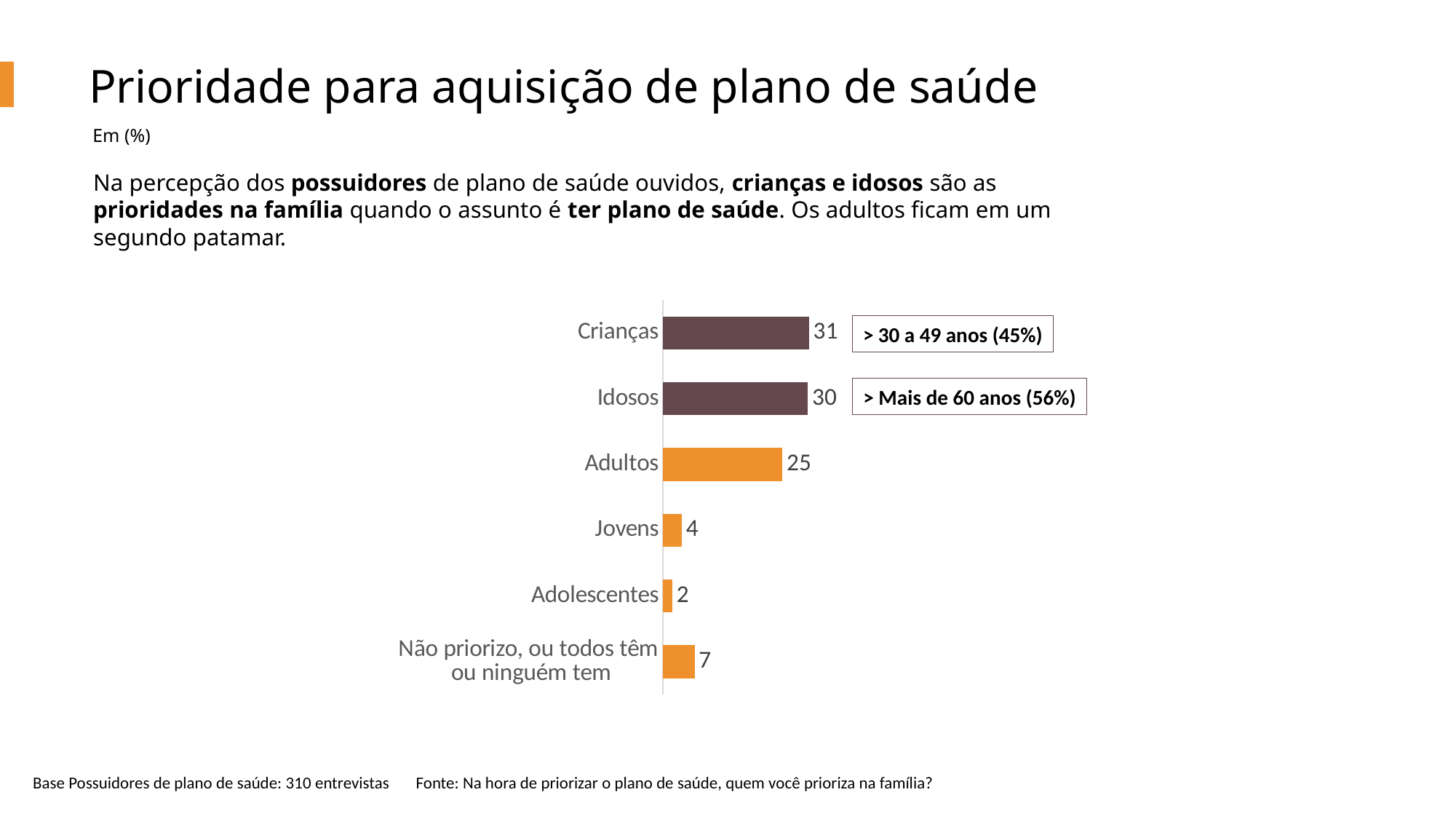
What kind of chart is shown on the slide? Bar chart What is the value for Jovens? 4 How many categories are shown in the chart? 6 What is the value for 'Não priorizo, ou todos têm ou ninguém tem'? 7 What is the value for Adultos? 25 Which category has the highest value? Crianças What is the title of the slide containing the chart? Prioridade para aquisição de plano de saúde Which category has the lowest value? Adolescentes What is the value for Crianças? 31 Which is larger, the value for Jovens or the value for 'Não priorizo, ou todos têm ou ninguém tem'? Não priorizo, ou todos têm ou ninguém tem What is the difference between the values for Crianças and Adultos? 6 What is the value for Idosos? 30